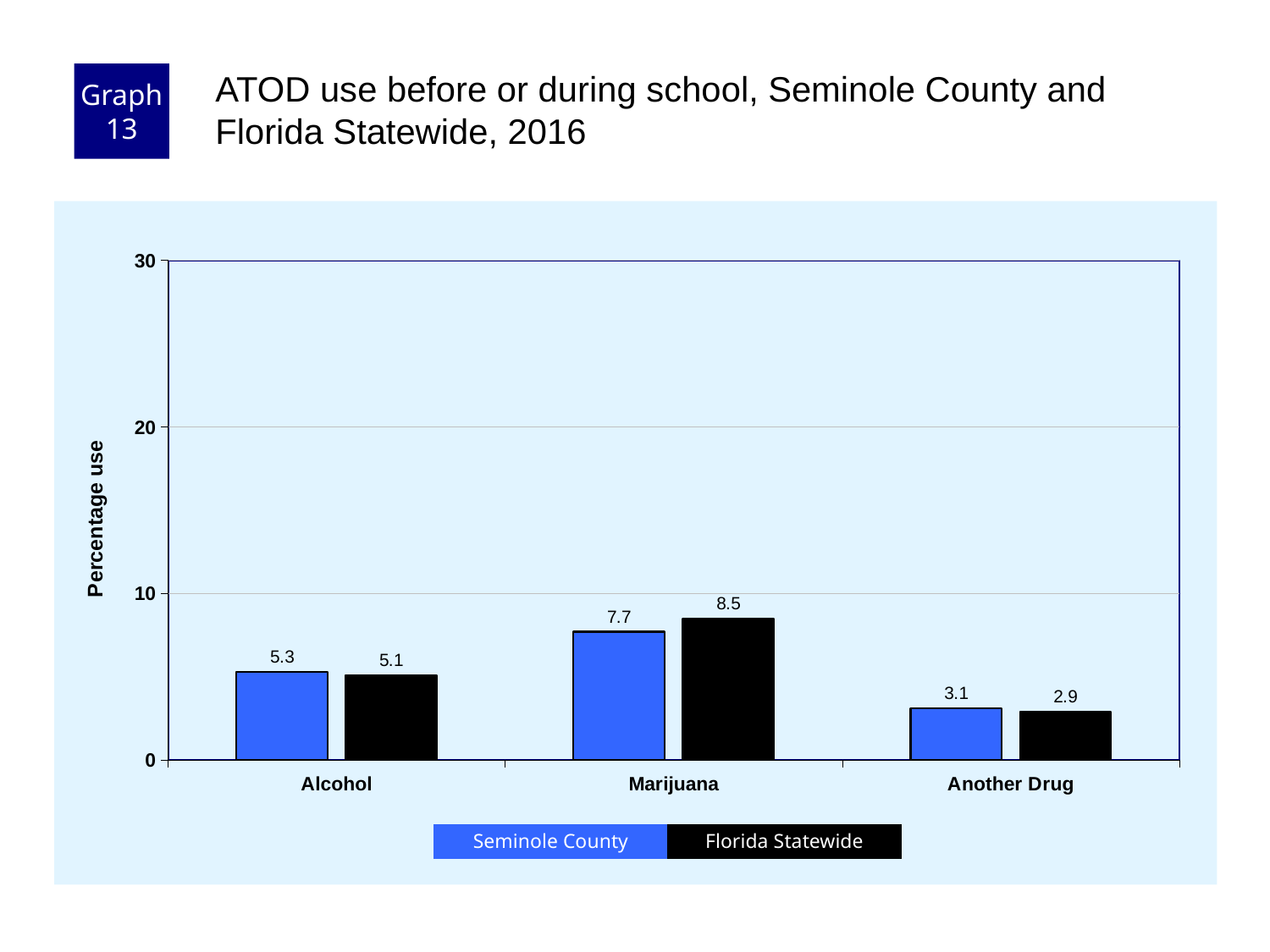
What kind of chart is shown on the slide? bar chart Which is larger for Another Drug, Seminole County or Florida Statewide? Seminole County What is the Seminole County value for Another Drug? 3.1 Which category has the highest Seminole County value? Marijuana What is the difference between the Florida Statewide and Seminole County values for Marijuana? 0.8 Which category has the lowest Florida Statewide value? Another Drug What is the Florida Statewide value for Alcohol? 5.1 What is the Florida Statewide value for Marijuana? 8.5 How many categories are shown on the x axis? 3 What is the Seminole County value for Alcohol? 5.3 Is the Florida Statewide value for Marijuana greater or less than 10? less How many series does the legend list? 2